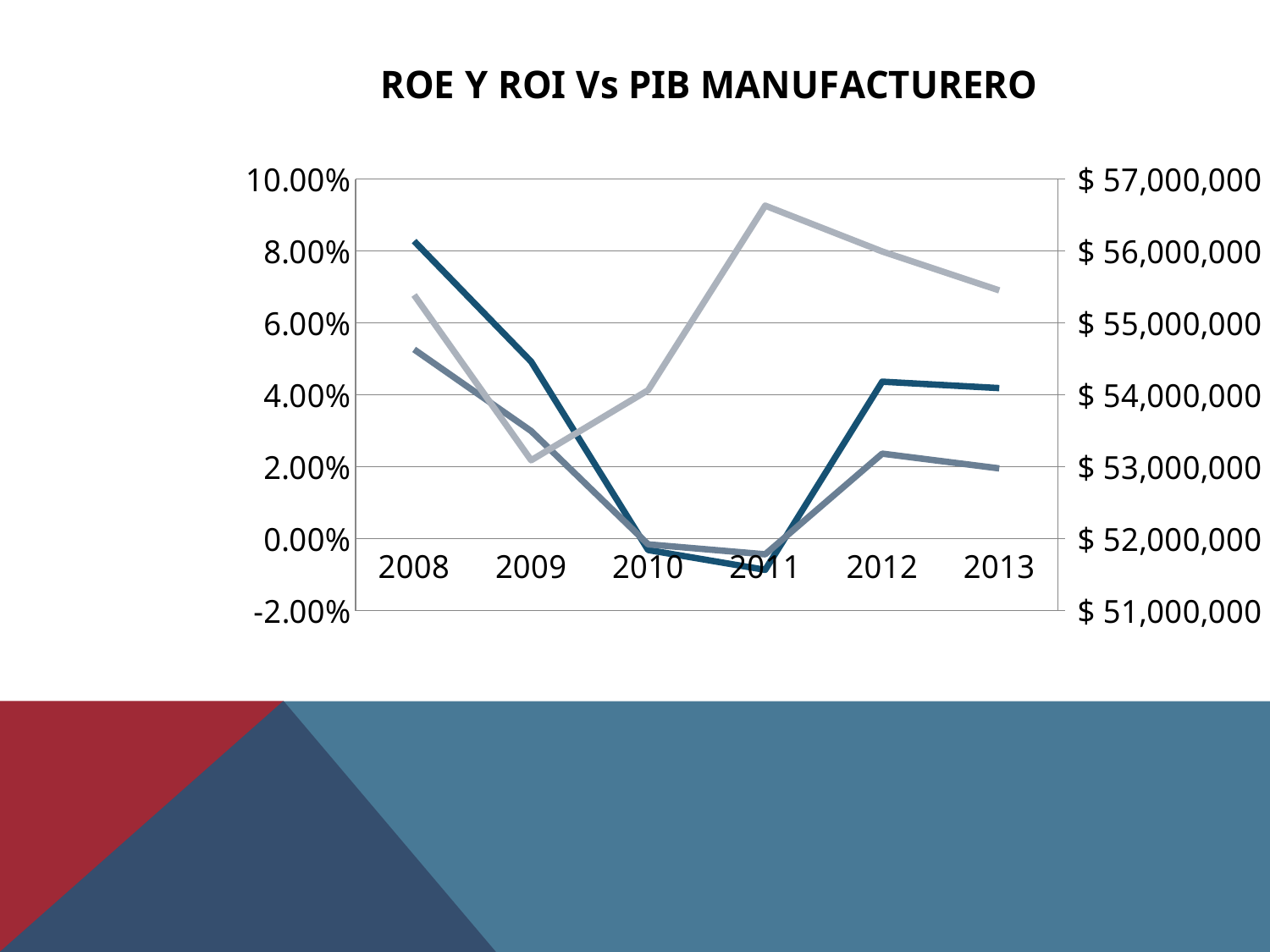
Is the value of the light gray line in 2011 greater or less than $ 56,000,000 on the right axis? greater What is the highest value shown on the right-hand axis? $ 57,000,000 What is the first year shown on the x axis? 2008 Does the dark blue line rise or fall from 2008 to 2010? fall Is the value of the light gray line in 2009 greater or less than $ 54,000,000 on the right axis? less Is the value of the dark blue line in 2008 greater or less than 6.00% on the left axis? greater How many years are shown on the x axis of the chart? 6 In which year does the light gray line reach its highest point? 2011 What is the title of the chart? ROE Y ROI Vs PIB MANUFACTURERO What kind of chart is shown on the slide? line chart In which year does the dark blue line reach its highest point? 2008